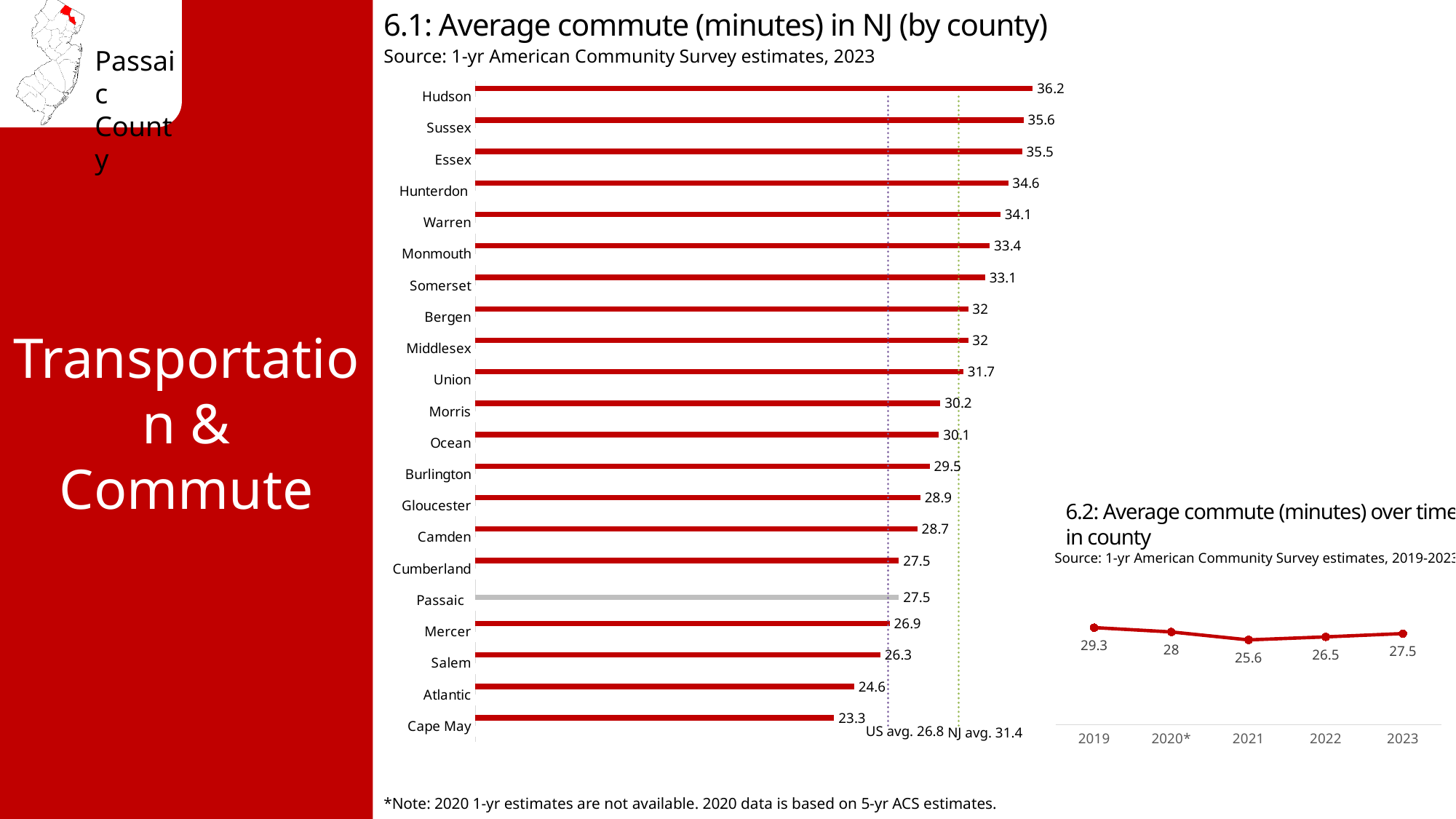
In chart 6.1 (Average commute in NJ by county), what is the average commute for Passaic? 27.5 What kind of chart is chart 6.1 (Average commute in NJ by county)? Bar chart In chart 6.1 (Average commute in NJ by county), which county has the lowest average commute? Cape May In chart 6.1 (Average commute in NJ by county), what is the NJ average commute shown by the reference line? 31.4 In chart 6.2 (Average commute over time in county), what is the difference between 2019 and 2021? 3.7 In chart 6.1 (Average commute in NJ by county), which county has the highest average commute? Hudson In chart 6.1 (Average commute in NJ by county), how many counties are shown? 21 In chart 6.1 (Average commute in NJ by county), what is the difference between Hudson and Cape May? 12.9 In chart 6.2 (Average commute over time in county), what is the value for 2021? 25.6 In chart 6.1 (Average commute in NJ by county), what is the average commute for Bergen? 32 In chart 6.1 (Average commute in NJ by county), which has a longer average commute, Morris or Mercer? Morris In chart 6.2 (Average commute over time in county), which year has the highest value? 2019